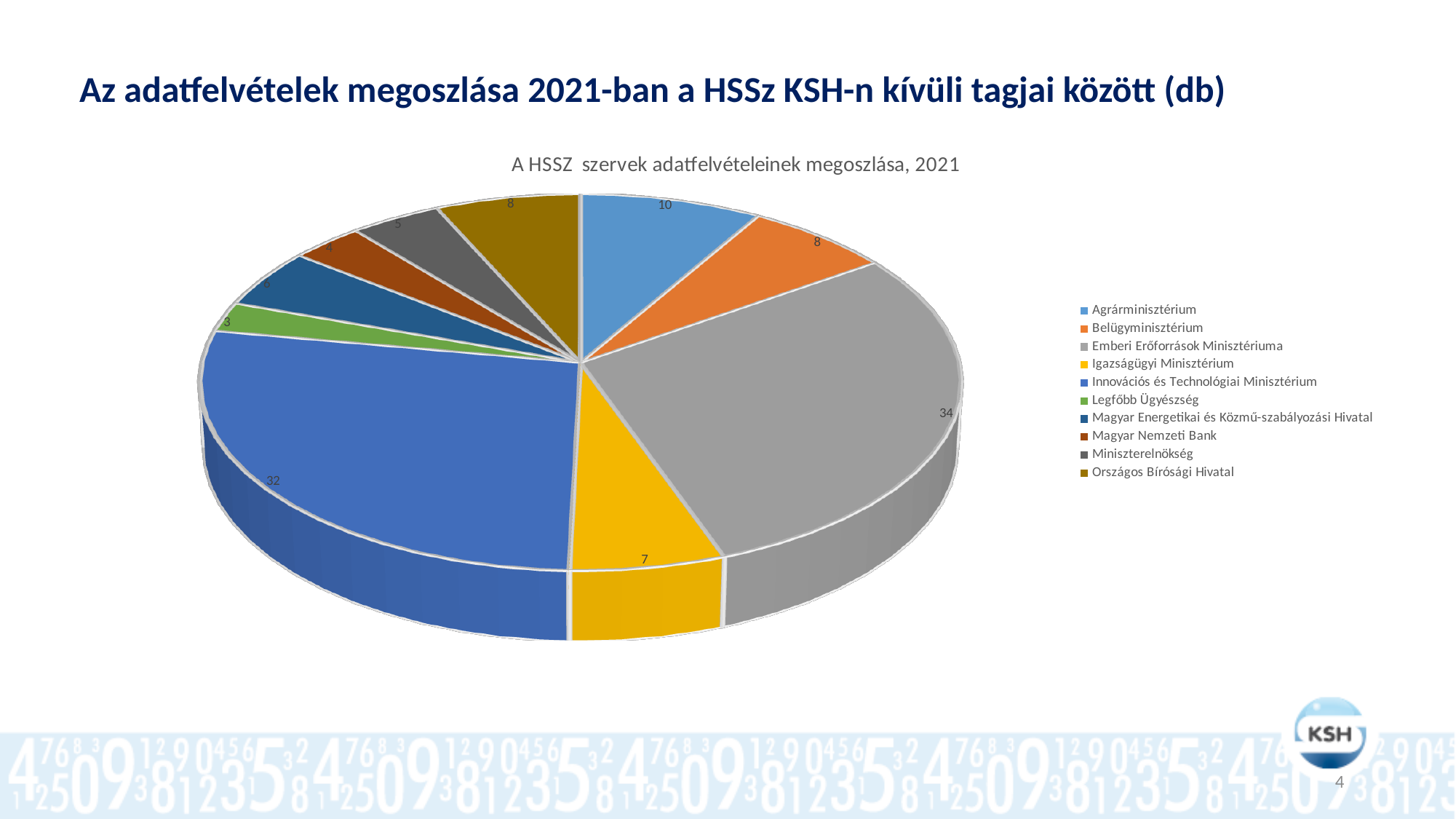
What is the difference between the values for Emberi Erőforrások Minisztériuma and Innovációs és Technológiai Minisztérium? 2 What is the value for Legfőbb Ügyészség? 3 Which is larger, the value for Agrárminisztérium or the value for Igazságügyi Minisztérium? Agrárminisztérium What is the title of the chart? A HSSZ szervek adatfelvételeinek megoszlása, 2021 What type of chart is shown on the slide? Pie chart What is the value for Agrárminisztérium? 10 Which organisation has the largest slice of the pie? Emberi Erőforrások Minisztériuma What is the total of all the values shown in the pie chart? 117 Which organisation has the smallest slice of the pie? Legfőbb Ügyészség How many categories does the legend list? 10 What is the value for Innovációs és Technológiai Minisztérium? 32 What is the value for Emberi Erőforrások Minisztériuma? 34